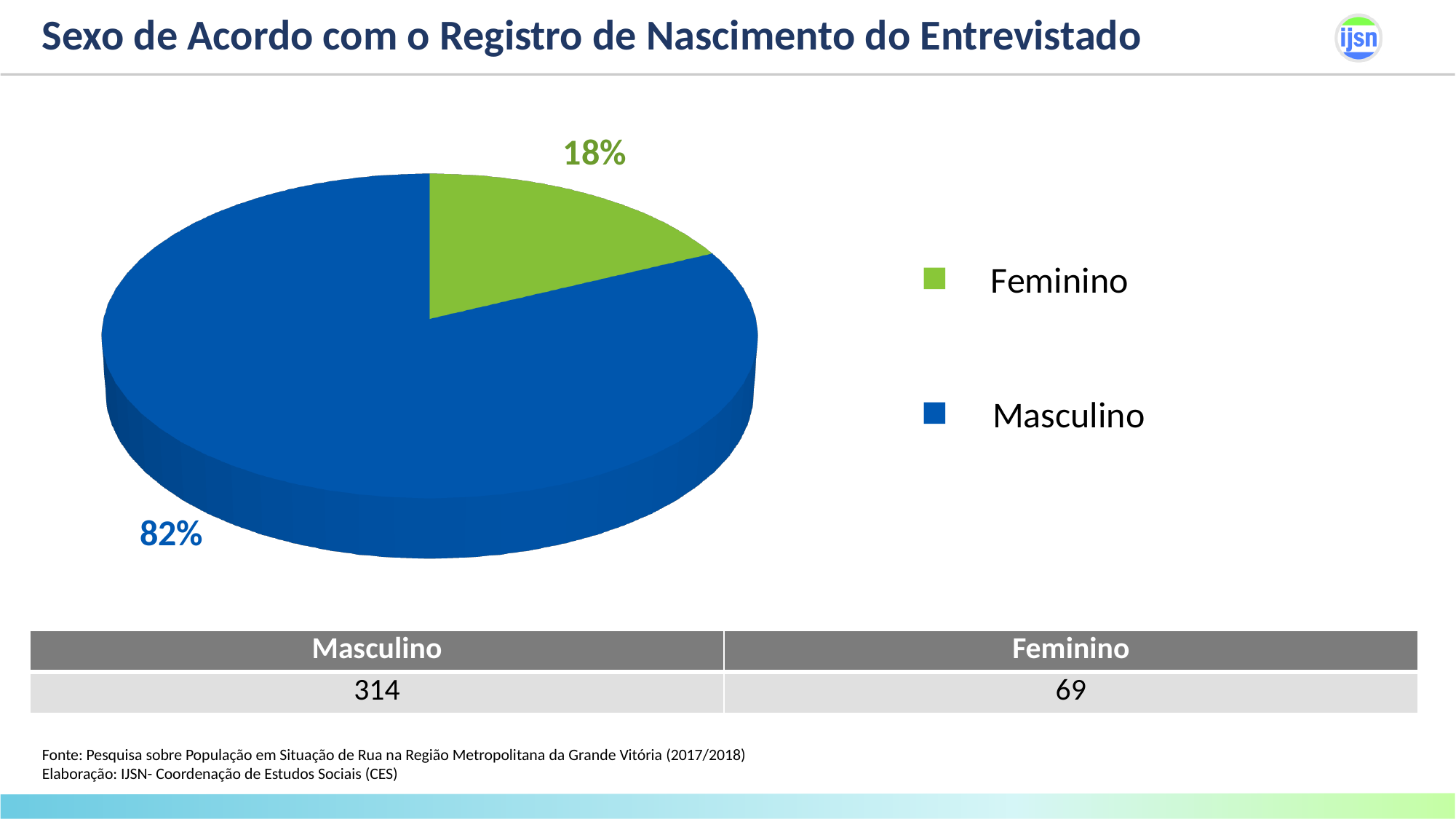
What colour is the Feminino slice? Green Which category has the smallest slice of the pie? Feminino How many slices does the pie chart have? 2 What is the difference in percentage points between the Masculino and Feminino slices? 64 What is the title of the chart? Sexo de Acordo com o Registro de Nascimento do Entrevistado What share of the pie does Feminino represent? 18% What kind of chart is shown on the slide? Pie chart Which category has the largest slice of the pie? Masculino How many entries does the legend list? 2 Which slice is larger, Feminino or Masculino? Masculino What share of the pie does Masculino represent? 82% According to the table below the chart, how many respondents are Masculino? 314